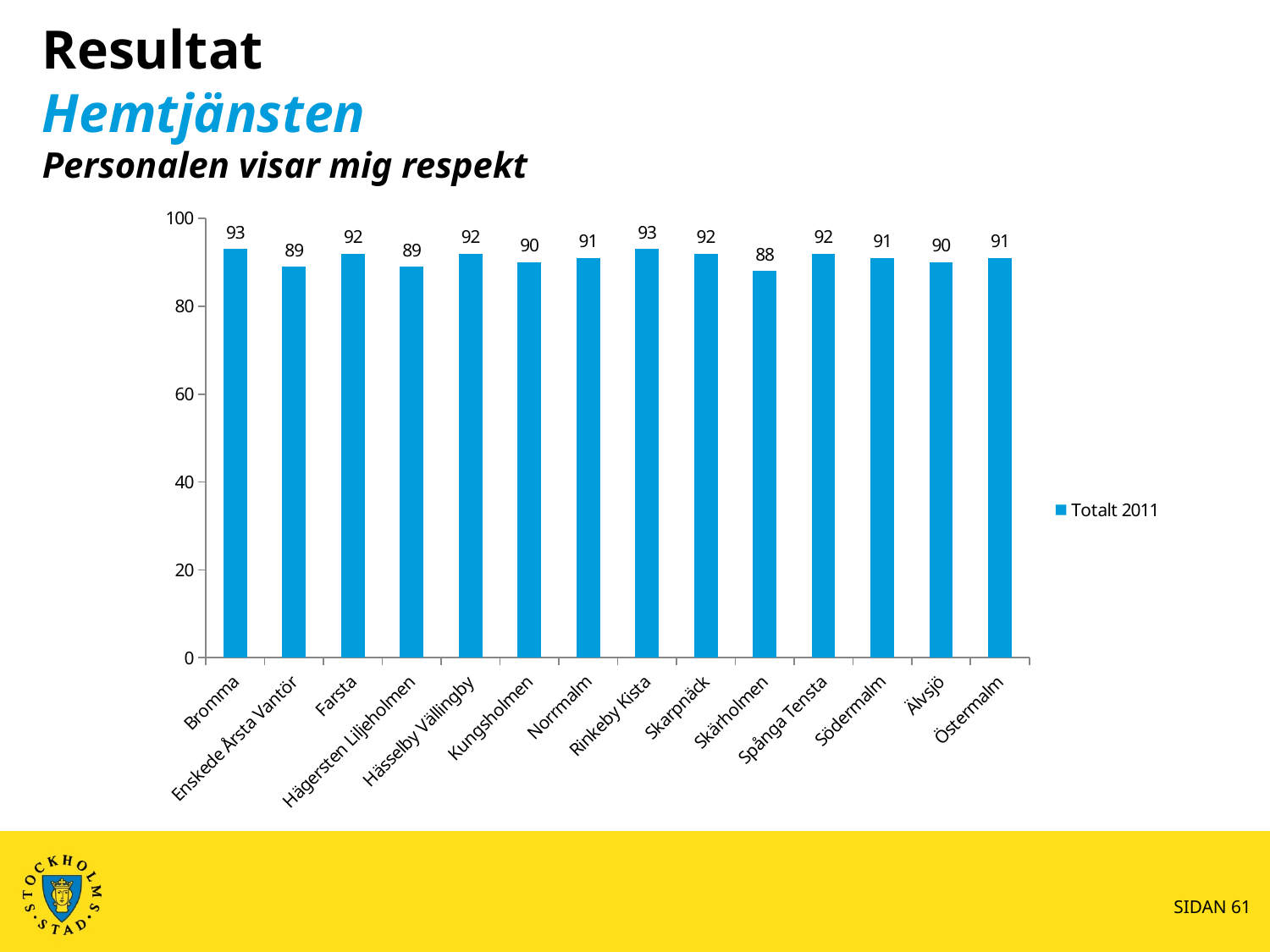
Which category has the lowest value? Skärholmen How many categories are shown on the x axis? 14 Which is larger, the value for Rinkeby Kista or the value for Hägersten Liljeholmen? Rinkeby Kista What kind of chart is shown on the slide? bar chart What is the value for Bromma? 93 What is the value for Spånga Tensta? 92 How many series does the legend list? 1 What is the difference between the values for Farsta and Enskede Årsta Vantör? 3 What is the value for Skärholmen? 88 Is the value for Östermalm greater or less than 80? greater What is the value for Kungsholmen? 90 What is the difference between the values for Bromma and Skärholmen? 5